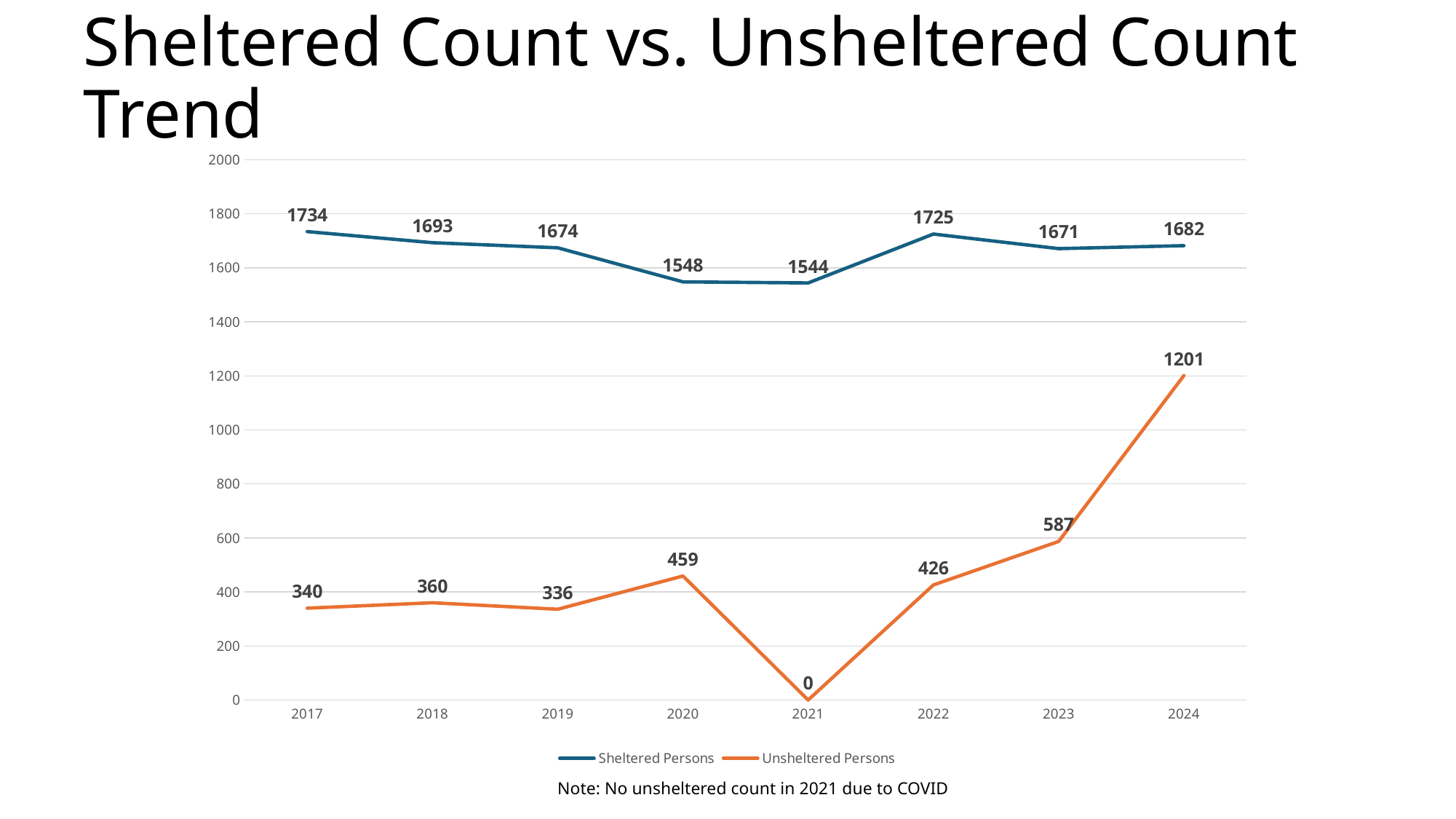
What is the title of the chart? Sheltered Count vs. Unsheltered Count Trend Does the Unsheltered Persons line rise or fall from 2022 to 2024? Rise In which year is the Unsheltered Persons value highest? 2024 In which year is the Sheltered Persons value lowest? 2021 How many years are shown on the x axis? 8 What kind of chart is shown on the slide? Line chart What is the Unsheltered Persons value for 2024? 1201 Which is larger, the Unsheltered Persons value in 2023 or in 2022? 2023 What is the Unsheltered Persons value for 2021? 0 How many series does the legend list? 2 What is the difference between the Sheltered Persons and Unsheltered Persons values in 2024? 481 What is the Sheltered Persons value for 2017? 1734